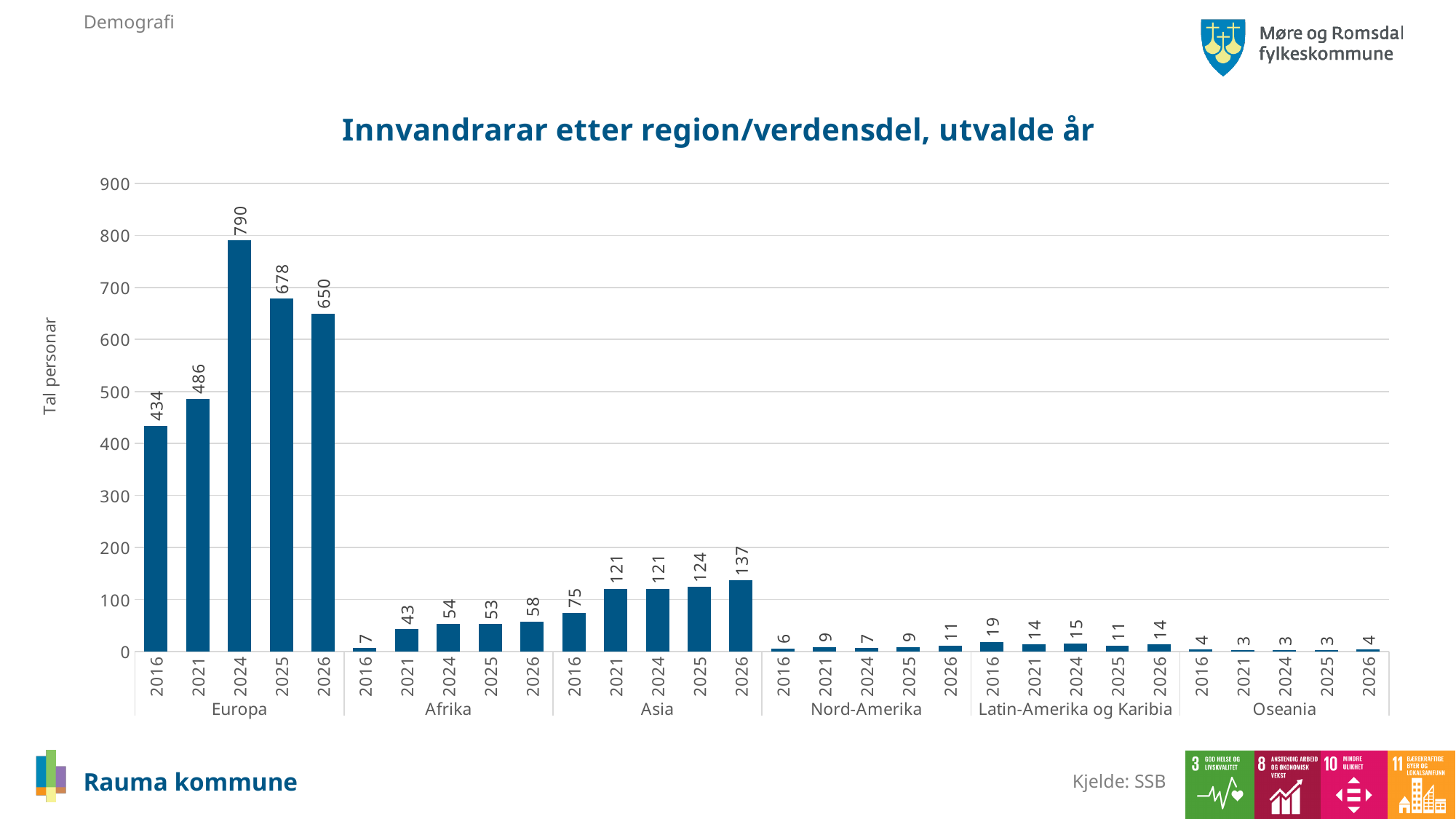
What is the title of the chart? Innvandrarar etter region/verdensdel, utvalde år What is the value for Europa in 2024? 790 What is the value for Afrika in 2016? 7 Which is larger: Latin-Amerika og Karibia in 2016 or Nord-Amerika in 2026? Latin-Amerika og Karibia in 2016 What is the difference between the Europa values for 2024 and 2026? 140 Which year has the lowest value for Nord-Amerika? 2016 How many regions are shown on the x axis? 6 Which region has the highest bar on the chart? Europa What kind of chart is shown on the slide? bar chart What is the value for Asia in 2026? 137 Is the value for Europa in 2021 greater or less than 400? greater Do the values for Asia rise or fall from 2016 to 2026? rise